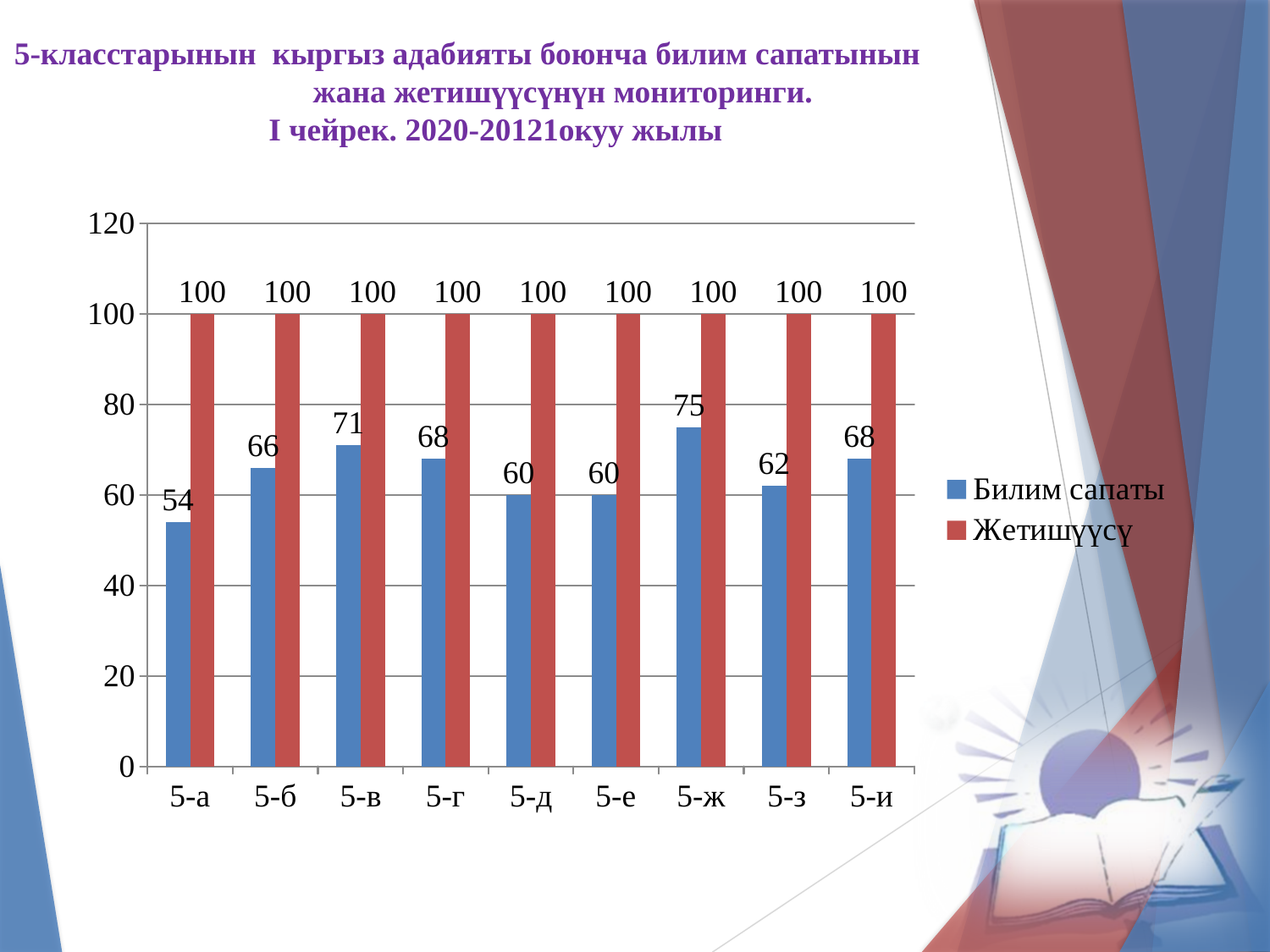
What is the value of Билим сапаты for 5-а? 54 Which category has the lowest Билим сапаты value? 5-а What is the value of Билим сапаты for 5-ж? 75 Which has a larger Билим сапаты value, 5-б or 5-в? 5-в Is the Билим сапаты value for 5-з greater or less than 80? less What is the value of Жетишүүсү for 5-д? 100 Which series is shown in red? Жетишүүсү How many categories are shown on the x axis? 9 Which category has the highest Билим сапаты value? 5-ж What kind of chart is shown on the slide? bar chart How many series does the legend list? 2 What is the difference between the Билим сапаты values for 5-ж and 5-а? 21